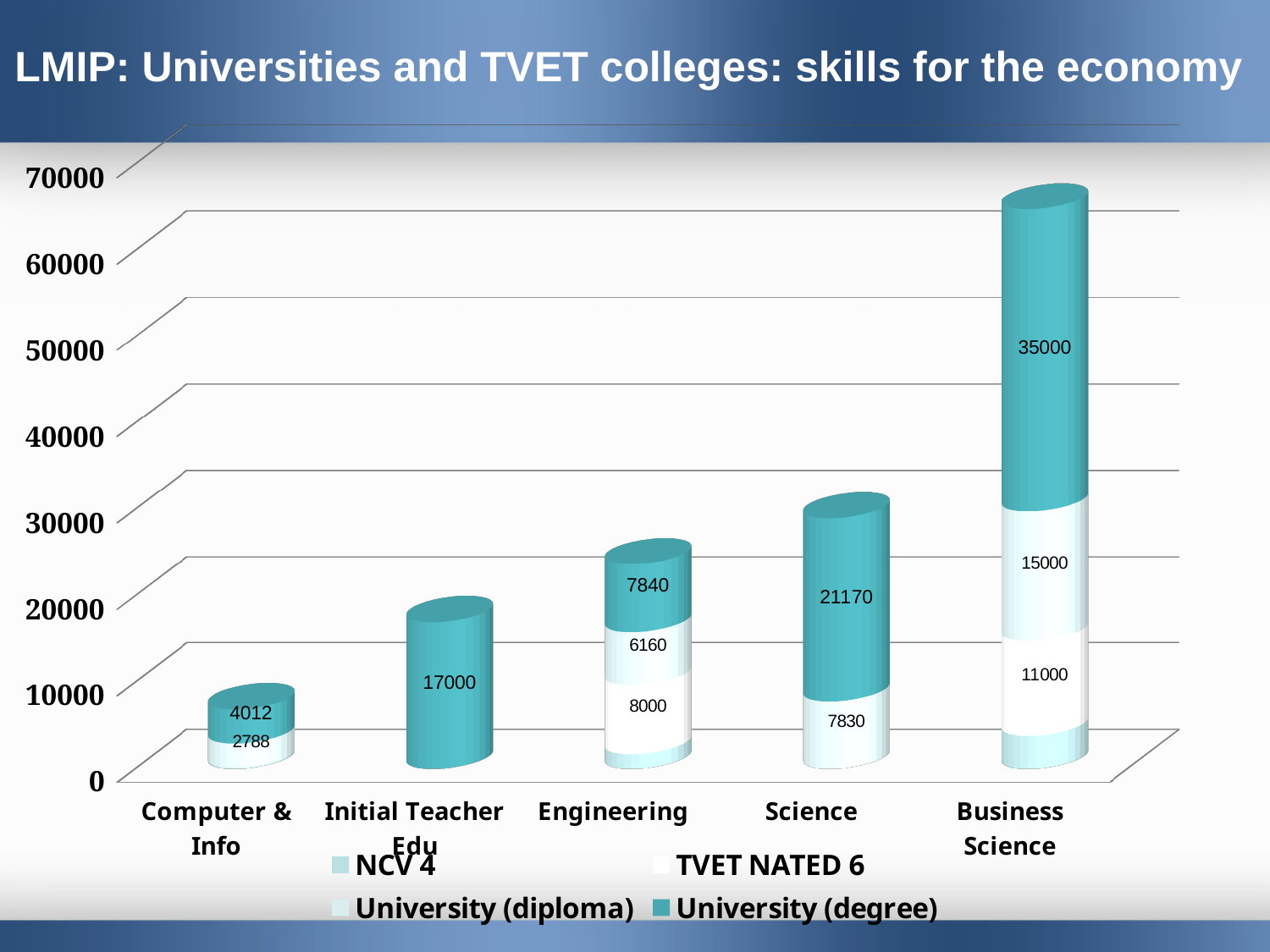
What is the difference between the University (degree) values for Business Science and Science? 13830 Which category has the lowest University (degree) value? Computer & Info How many series does the legend list? 4 What is the University (degree) value for Science? 21170 What kind of chart is shown on the slide? Stacked bar chart What is the University (degree) value for Business Science? 35000 Is the total height of the Business Science bar greater or less than 60000? greater Which has a larger University (degree) value, Science or Initial Teacher Edu? Science How many categories are shown on the x axis? 5 What is the University (degree) value for Initial Teacher Edu? 17000 What is the University (degree) value for Engineering? 7840 Which category has the highest University (degree) value? Business Science